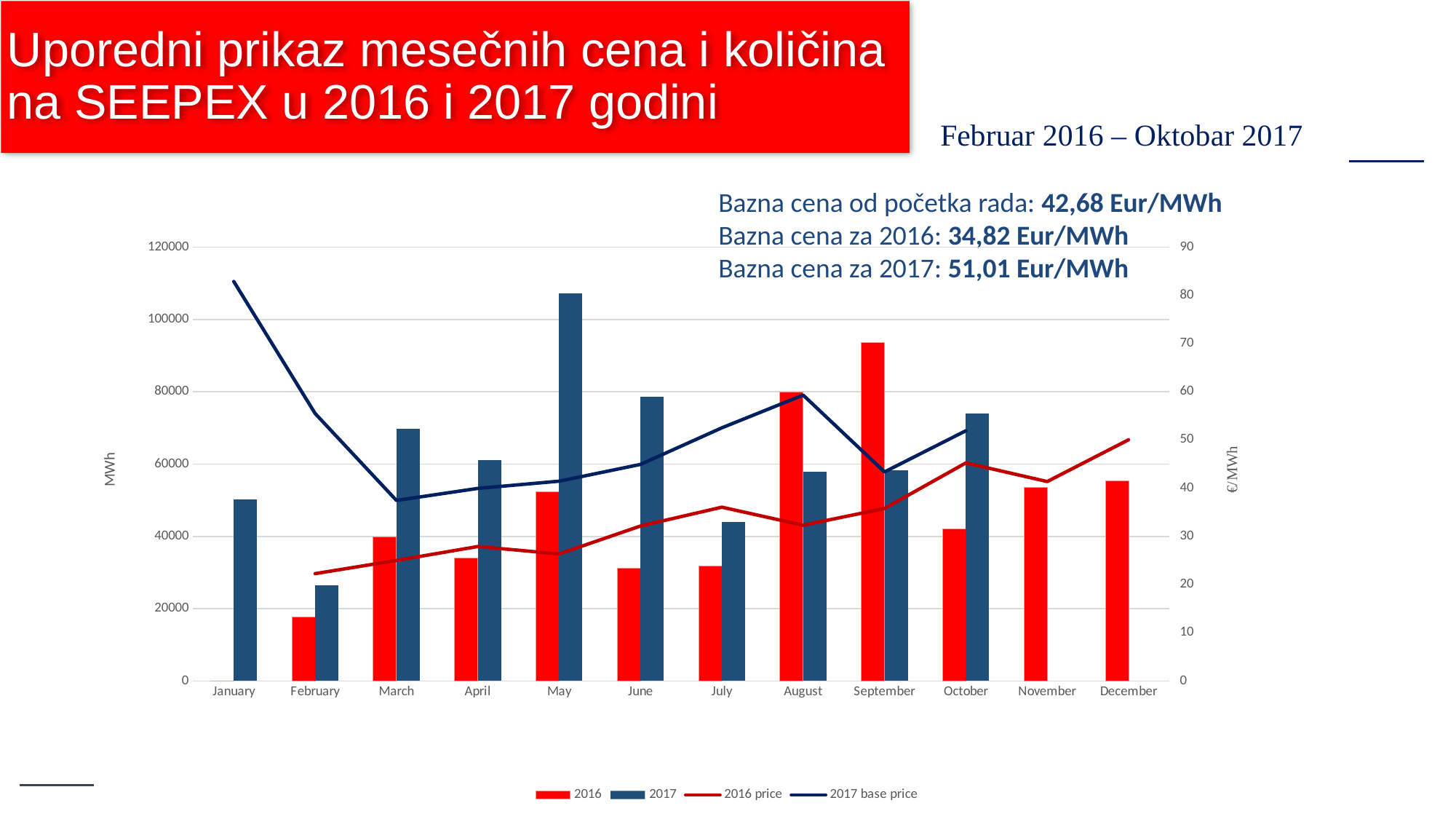
Is the 2017 value for May greater or less than 100000 MWh? greater Is the 2016 value for September greater or less than 80000 MWh? greater In which month is the 2016 bar (MWh) the highest? September What kind of chart is shown on the slide? A combination bar and line chart Does the 2017 base price line rise or fall from January to March? fall In March, which bar is larger, 2016 or 2017? 2017 In which month is the 2016 bar (MWh) the lowest? February How many months are shown on the x axis? 12 How many series does the legend list? 4 In which month is the 2017 bar (MWh) the lowest? February In which month is the 2017 bar (MWh) the highest? May In September, which bar is larger, 2016 or 2017? 2016